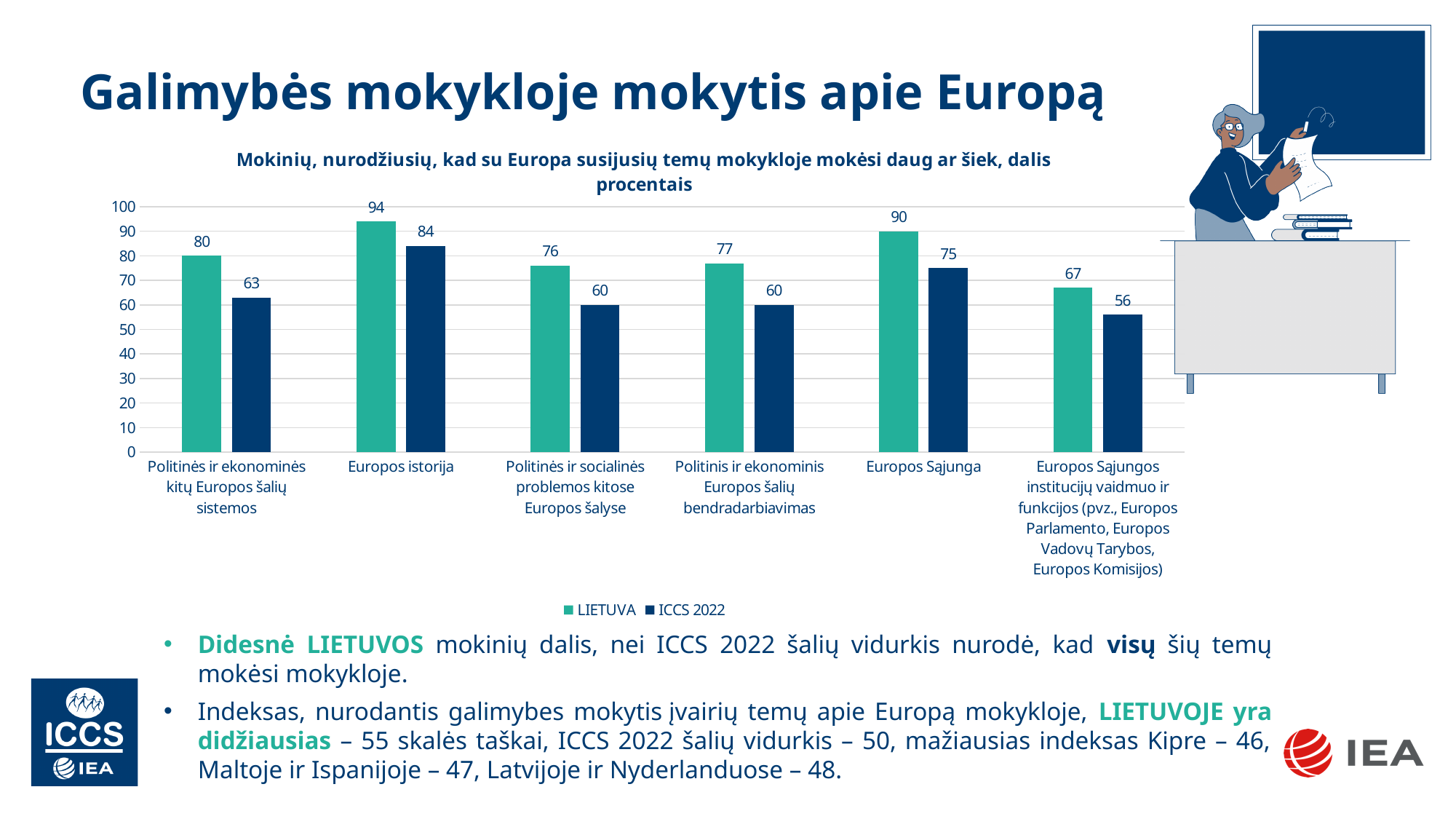
Which category has the lowest ICCS 2022 value? Europos Sąjungos institucijų vaidmuo ir funkcijos (pvz., Europos Parlamento, Europos Vadovų Tarybos, Europos Komisijos) Which category has the highest LIETUVA value? Europos istorija Is the ICCS 2022 value for Politinės ir socialinės problemos kitose Europos šalyse greater or less than 70? less What is the LIETUVA value for Europos istorija? 94 How many series does the legend list? 2 Which is larger for Europos Sąjunga: the LIETUVA value or the ICCS 2022 value? LIETUVA What is the ICCS 2022 value for Politinės ir ekonominės kitų Europos šalių sistemos? 63 What is the ICCS 2022 value for Europos Sąjunga? 75 Which series is shown in dark blue in the legend? ICCS 2022 What kind of chart is shown on the slide? Bar chart What is the difference between the LIETUVA and ICCS 2022 values for Politinis ir ekonominis Europos šalių bendradarbiavimas? 17 How many categories are shown on the x axis? 6